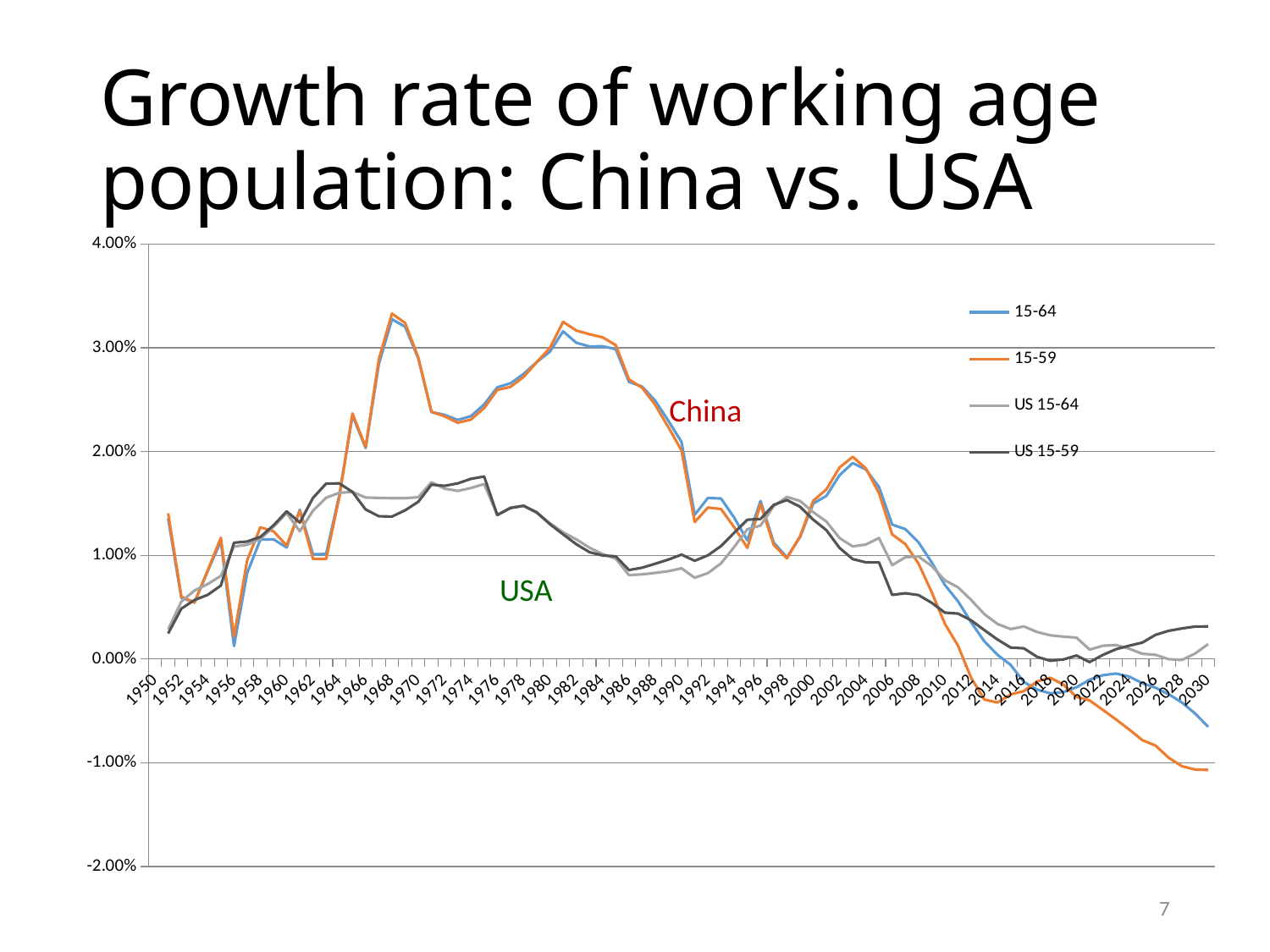
Does the 15-59 series rise or fall from 2004 to 2030? fall Which series are listed in the legend? 15-64, 15-59, US 15-64, US 15-59 In 1980, which is larger: the 15-64 series or the US 15-64 series? 15-64 In 2030, which is larger: the 15-59 series or the US 15-59 series? US 15-59 Is the value for the US 15-59 series in 2020 greater or less than 1.00%? less What is the title of the chart? Growth rate of working age population: China vs. USA Is the value for the US 15-64 series in 1964 greater or less than 1.00%? greater What kind of chart is shown on the slide? line chart Is the value for the 15-64 series in 2030 greater or less than 0.00%? less How many series does the legend list? 4